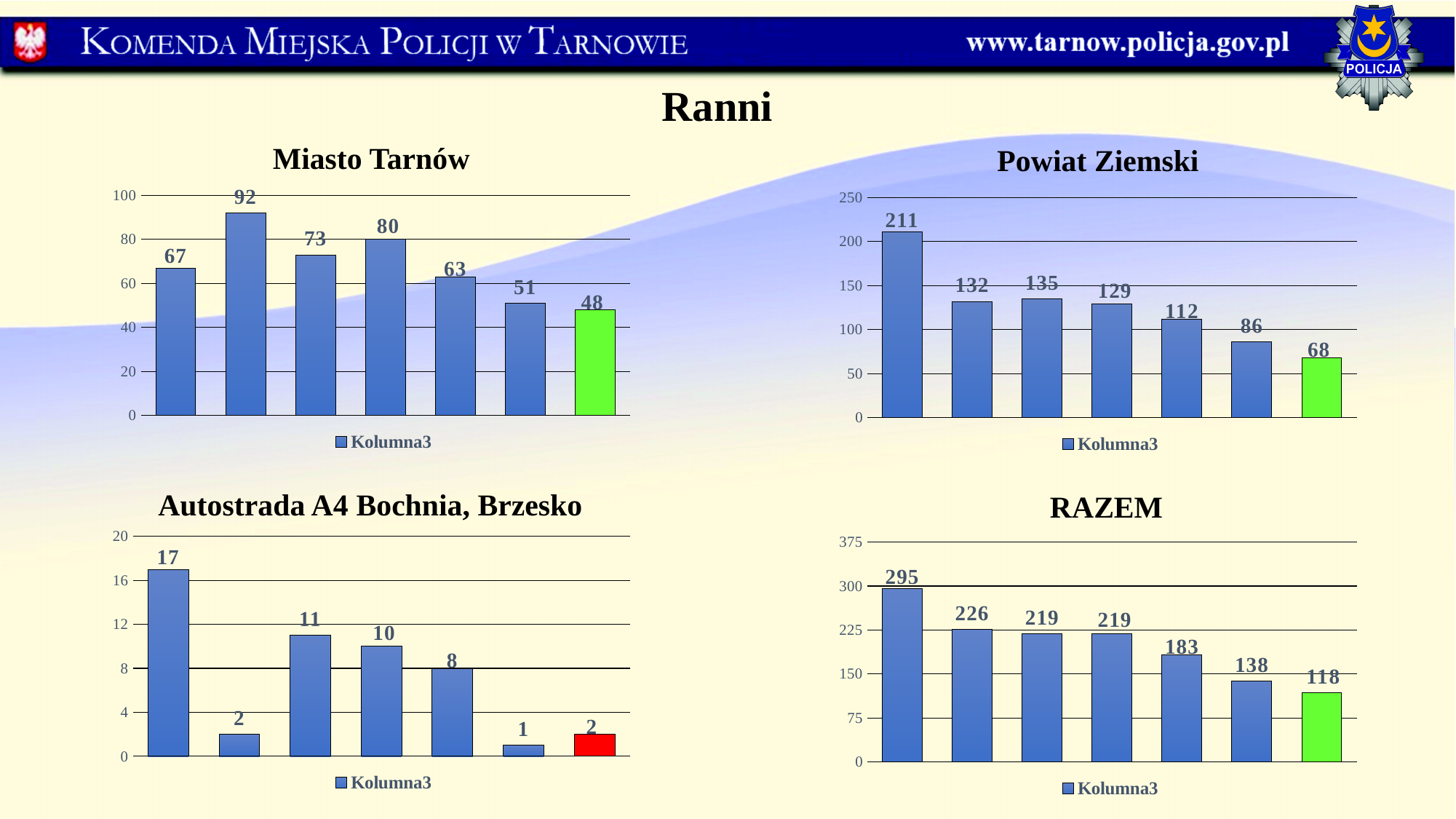
In the Powiat Ziemski chart, what is the value of the first (leftmost) bar? 211 How many bars are plotted in the Miasto Tarnów chart? 7 In the RAZEM chart, what is the value of the last (green) bar? 118 In the Powiat Ziemski chart, which is larger: the second bar (132) or the third bar (135)? the third bar (135) In the RAZEM chart, do the values generally rise or fall from left to right? fall What is the legend entry shown under the Miasto Tarnów chart? Kolumna3 In the Miasto Tarnów chart, what is the highest value shown? 92 What type of chart is the RAZEM chart? bar chart In the Autostrada A4 Bochnia, Brzesko chart, what colour is the last bar? red In the Autostrada A4 Bochnia, Brzesko chart, what is the lowest value shown? 1 In the Powiat Ziemski chart, what is the difference between the first bar (211) and the last bar (68)? 143 How many series does the legend of the Miasto Tarnów chart list? 1